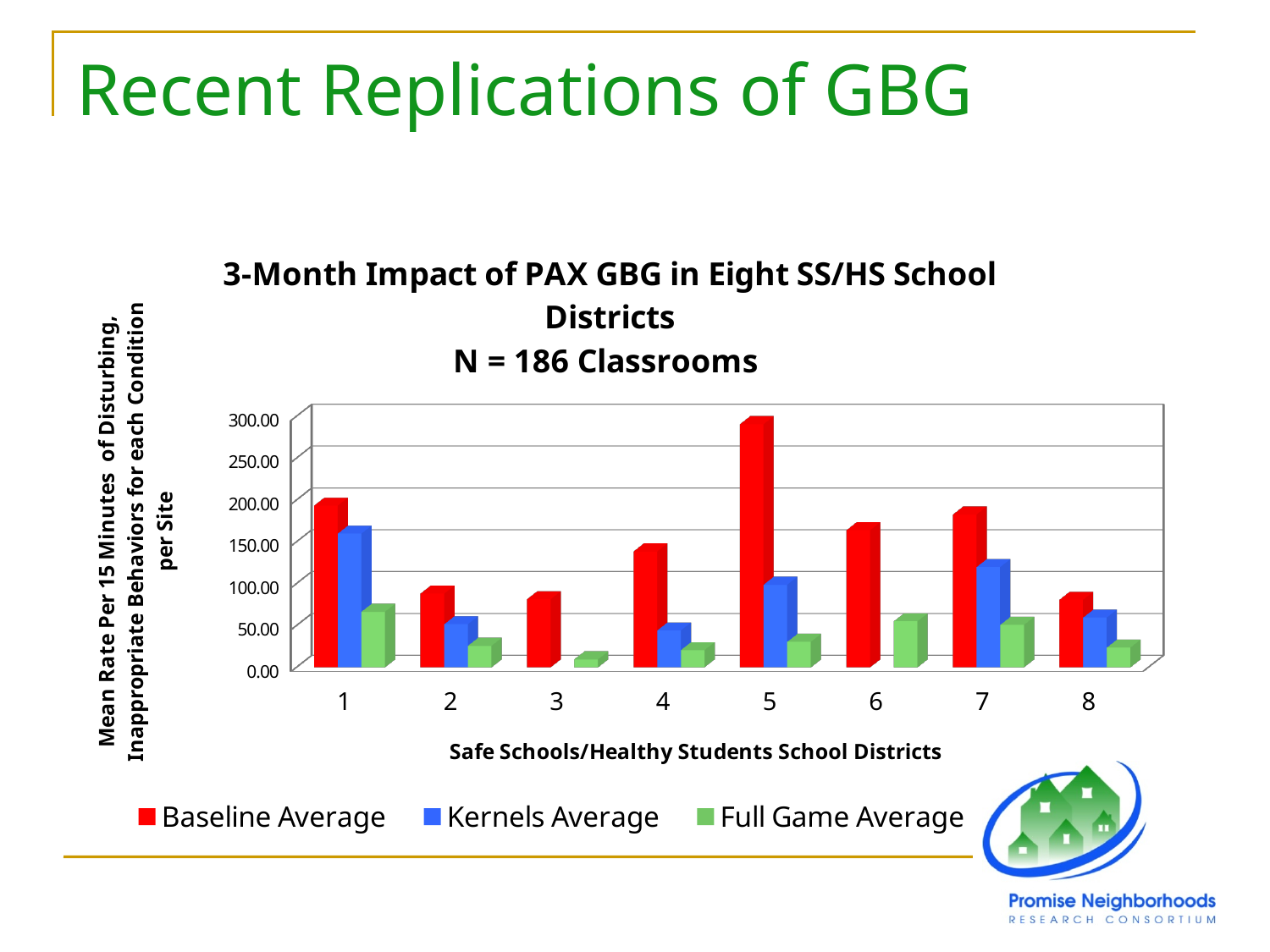
Which school district has the highest Kernels Average? 1 Is the Kernels Average for district 1 greater or less than 150.00? greater How many school districts are shown along the x axis? 8 For district 7, which is larger: the Baseline Average or the Kernels Average? Baseline Average According to the chart title, how many classrooms were included (N)? 186 Is the Baseline Average for district 5 greater or less than 250.00? greater What kind of chart is shown on the slide? bar chart Is the Baseline Average for district 2 greater or less than 100.00? less Which series is shown in green in the legend? Full Game Average How many series does the legend list? 3 Which school district has the highest Baseline Average? 5